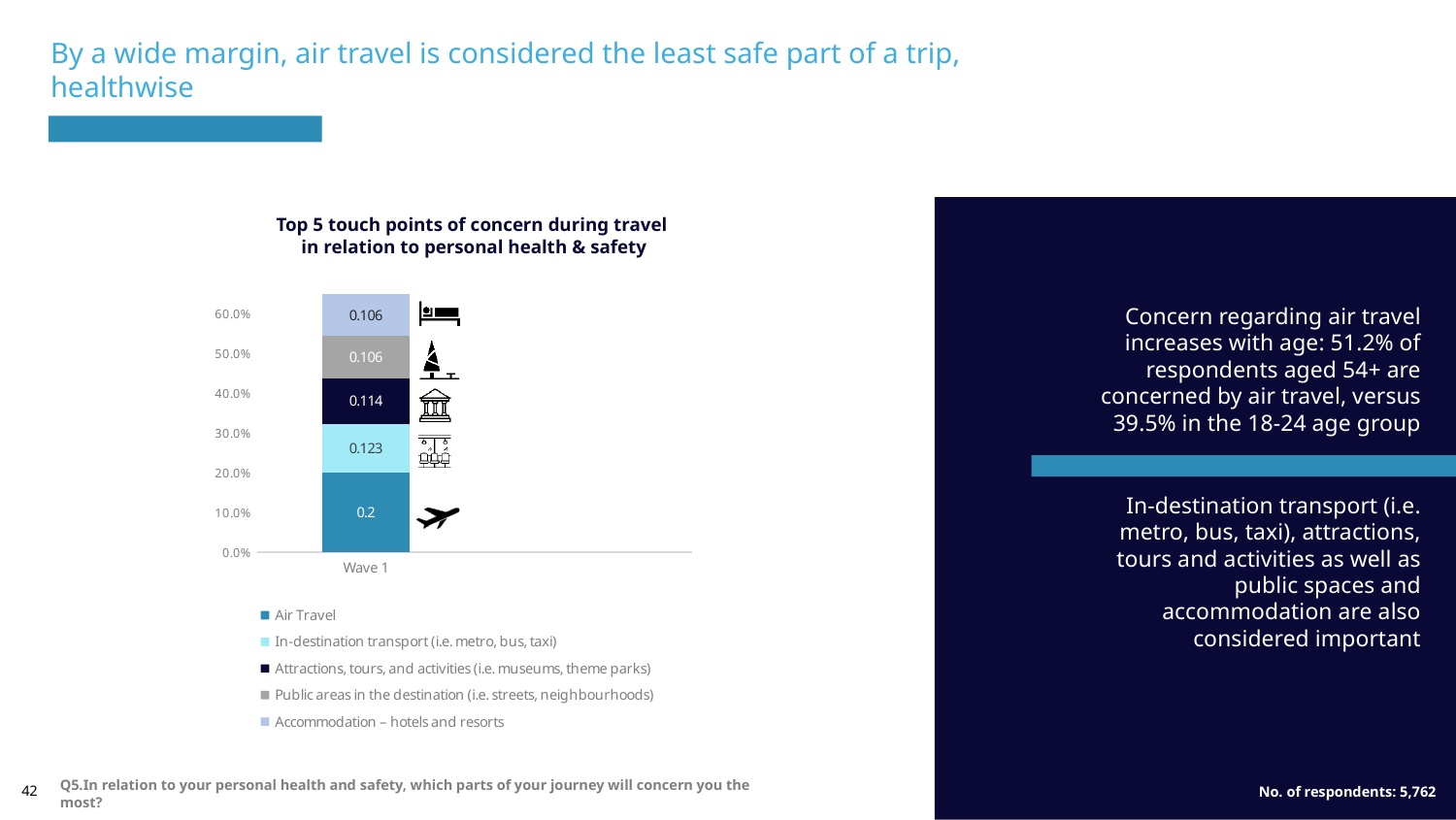
How many series does the legend list? 5 What is the value shown for Attractions, tours, and activities (i.e. museums, theme parks)? 0.114 Which is larger, the value for Attractions, tours, and activities or the value for Public areas in the destination? Attractions, tours, and activities What is the title of the chart? Top 5 touch points of concern during travel in relation to personal health & safety What is the value shown for Air Travel in the chart? 0.2 Which series has the highest value in the stacked bar? Air Travel What is the difference between the Air Travel value and the In-destination transport value? 0.077 What is the value shown for In-destination transport (i.e. metro, bus, taxi)? 0.123 What is the value shown for Accommodation – hotels and resorts? 0.106 What is the category label on the x axis of the chart? Wave 1 What type of chart is shown on the slide? Stacked bar chart What is the total of the stacked bar for Wave 1? 0.649